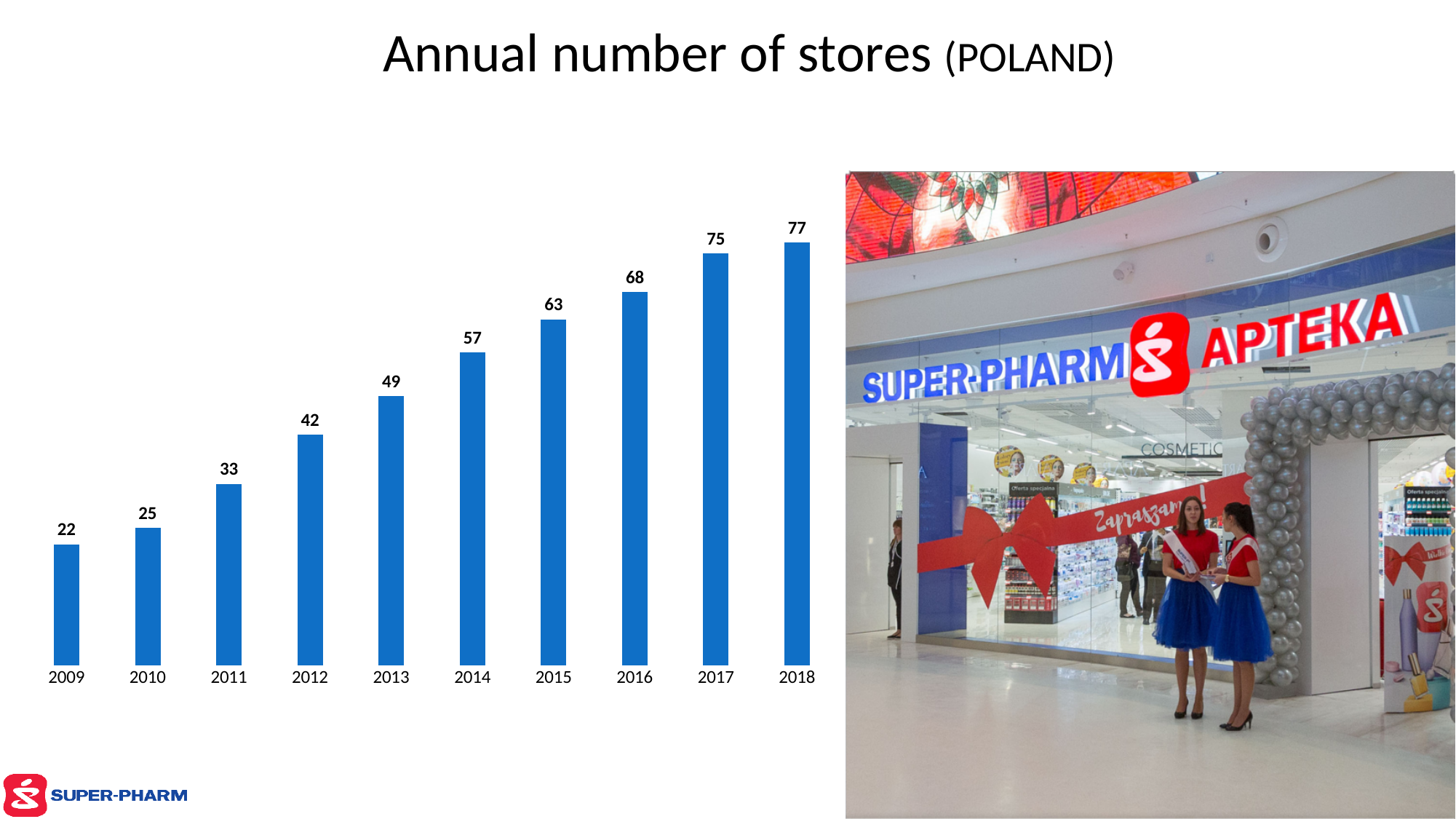
Which year has more stores, 2012 or 2011? 2012 Which year has the lowest number of stores? 2009 What is the difference in the number of stores between 2018 and 2009? 55 What is the number of stores in 2016? 68 Which year has the highest number of stores? 2018 What is the number of stores in 2013? 49 What kind of chart is shown on the slide? Bar chart What is the number of stores in 2009? 22 Does the number of stores rise or fall from 2009 to 2018? Rise What is the difference in the number of stores between 2015 and 2014? 6 What is the title of the chart? Annual number of stores (POLAND) How many years are shown on the chart? 10